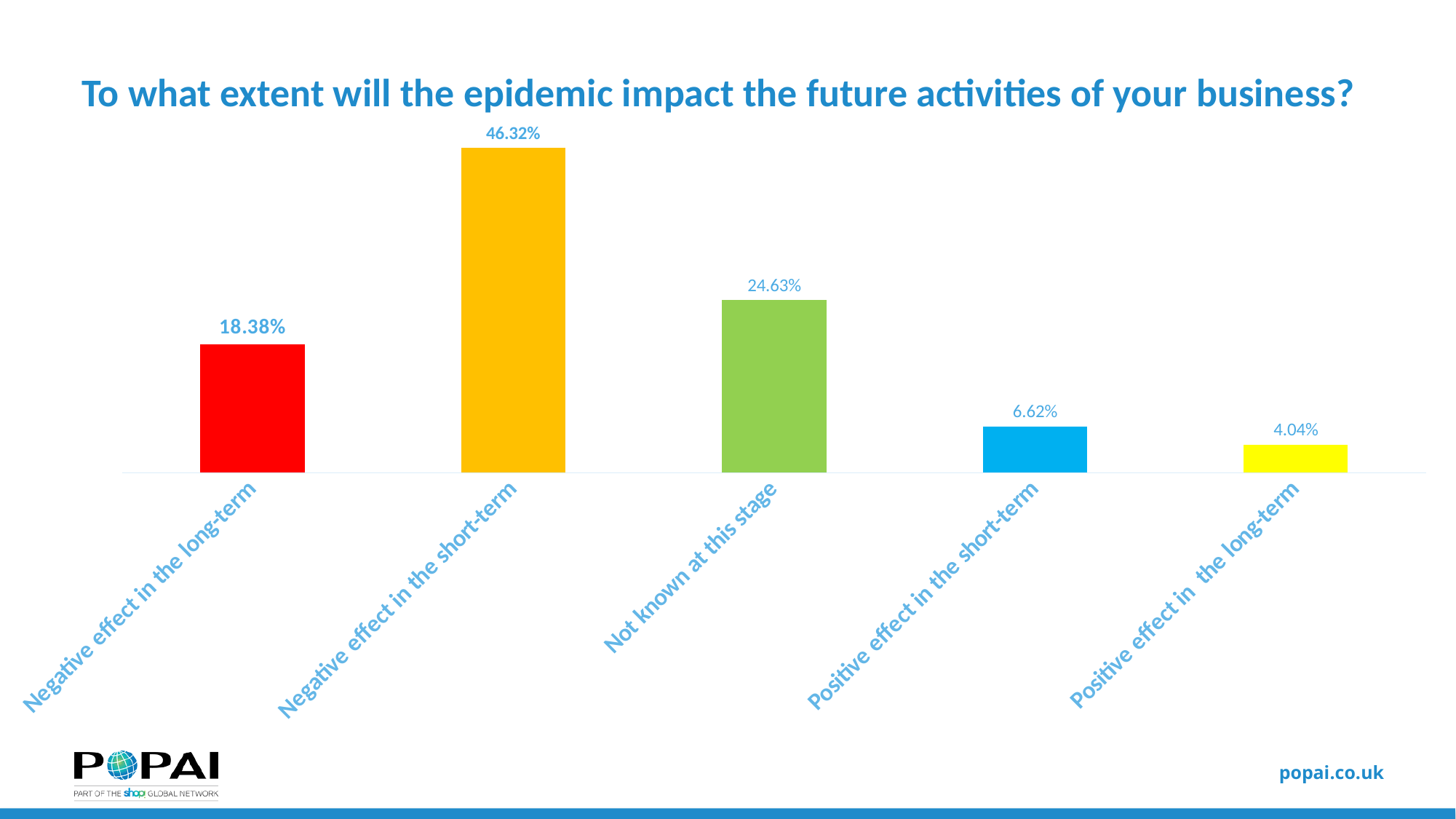
What colour is the bar for 'Negative effect in the short-term'? Orange What kind of chart is shown on the slide? Bar chart Which category has the lowest value? Positive effect in the long-term How many categories are shown in the chart? 5 What percentage of respondents expect a negative effect in the short-term? 46.32% What percentage of respondents expect a positive effect in the long-term? 4.04% What is the value for 'Not known at this stage'? 24.63% Which is larger: 'Negative effect in the long-term' or 'Not known at this stage'? Not known at this stage What is the difference between 'Negative effect in the short-term' and 'Not known at this stage'? 21.69% Which category has the highest value? Negative effect in the short-term What is the value for 'Negative effect in the long-term'? 18.38% What is the difference between 'Positive effect in the short-term' and 'Positive effect in the long-term'? 2.58%